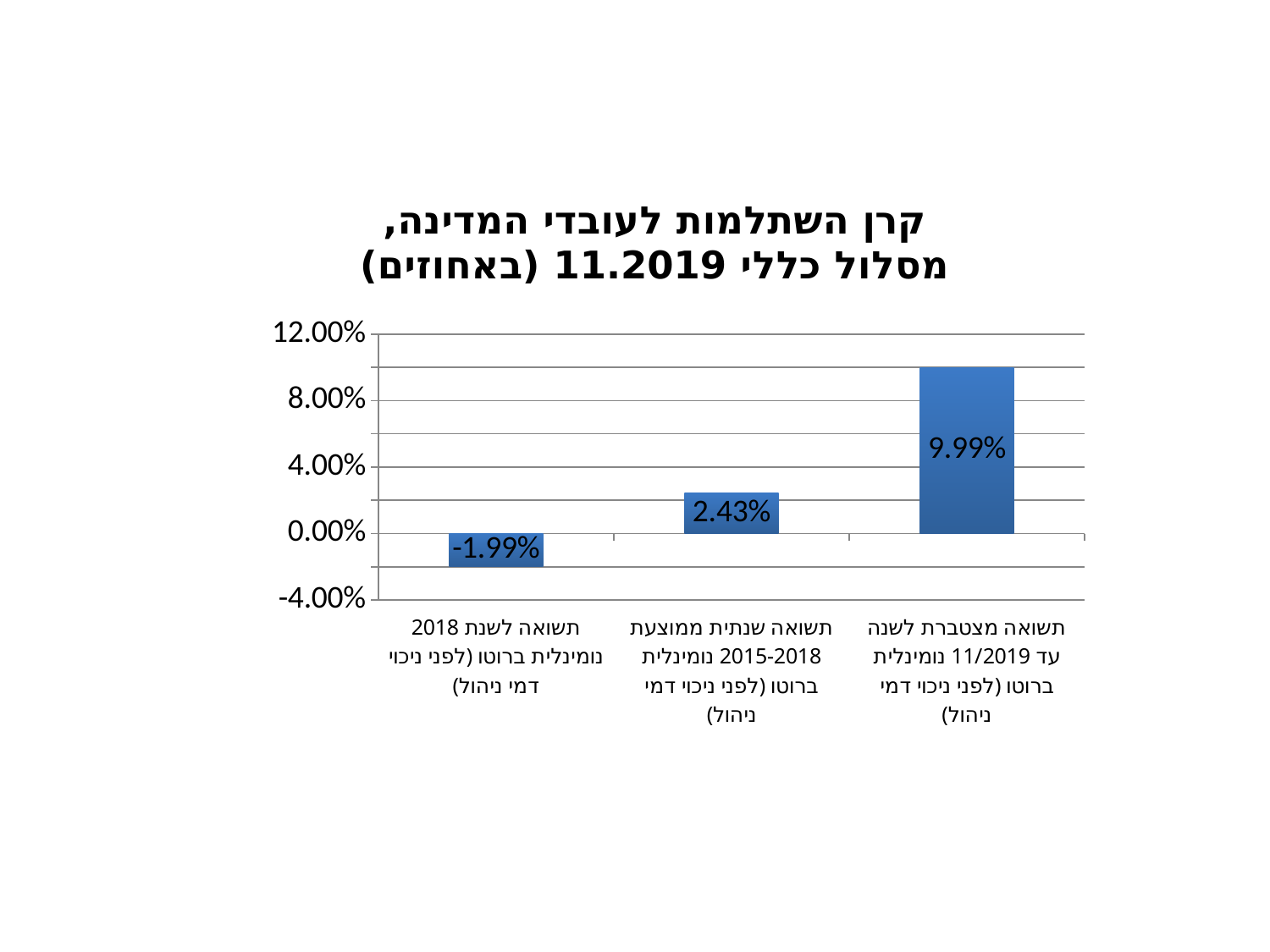
What is the value for the category "תשואה מצטברת לשנה עד 11/2019 נומינלית ברוטו (לפני ניכוי דמי ניהול)"? 9.99% What is the title of the chart? קרן השתלמות לעובדי המדינה, מסלול כללי 11.2019 (באחוזים) Which category has the lowest value? תשואה לשנת 2018 נומינלית ברוטו (לפני ניכוי דמי ניהול) How many categories are shown in the chart? 3 Which category has the highest value? תשואה מצטברת לשנה עד 11/2019 נומינלית ברוטו (לפני ניכוי דמי ניהול) Which is larger: the value for "תשואה שנתית ממוצעת 2015-2018" or the value for "תשואה לשנת 2018"? תשואה שנתית ממוצעת 2015-2018 Is the value for "תשואה מצטברת לשנה עד 11/2019" greater or less than 8.00%? greater What is the difference between the value for "תשואה מצטברת לשנה עד 11/2019" and the value for "תשואה שנתית ממוצעת 2015-2018"? 7.56% What is the value for the category "תשואה לשנת 2018 נומינלית ברוטו (לפני ניכוי דמי ניהול)"? -1.99% What is the difference between the value for "תשואה שנתית ממוצעת 2015-2018" and the value for "תשואה לשנת 2018"? 4.42% What is the value for the category "תשואה שנתית ממוצעת 2015-2018 נומינלית ברוטו (לפני ניכוי דמי ניהול)"? 2.43% What kind of chart is shown on the slide? bar chart